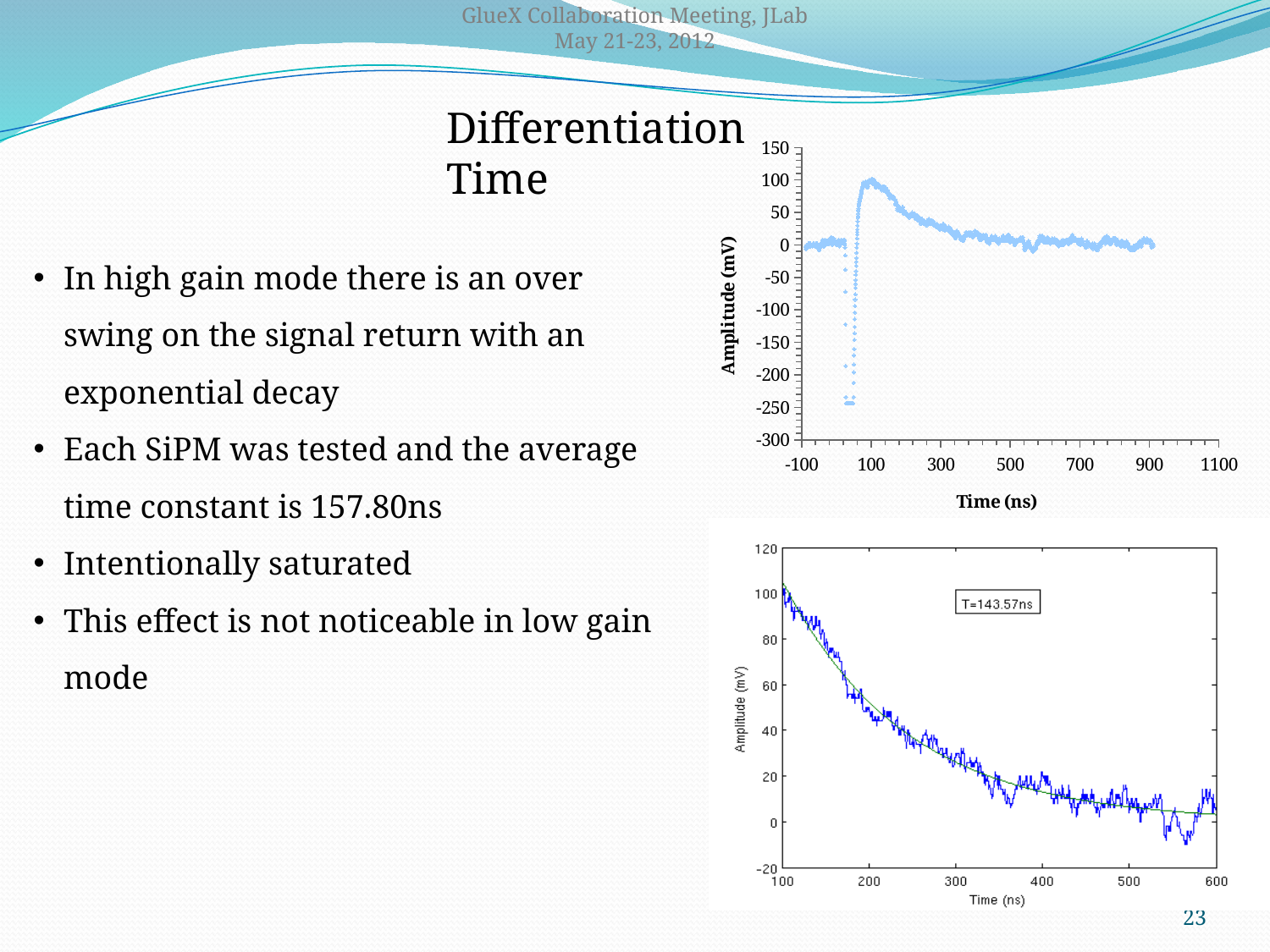
In the top chart, what is the label on the y axis? Amplitude (mV) In the bottom chart, is the amplitude at 500 ns greater or less than 40? less In the bottom chart, what time constant value is printed in the text box? T=143.57ns In the bottom chart, is the amplitude at 100 ns greater or less than 80? greater In the top chart, is the amplitude at 900 ns greater or less than 50? less In the bottom chart, does the amplitude rise or fall as time increases from 100 ns to 600 ns? fall In the top chart, what is the label on the x axis? Time (ns) In the top chart, which is larger in absolute amplitude, the negative dip or the positive overshoot? the negative dip What kind of chart is the bottom chart? line chart